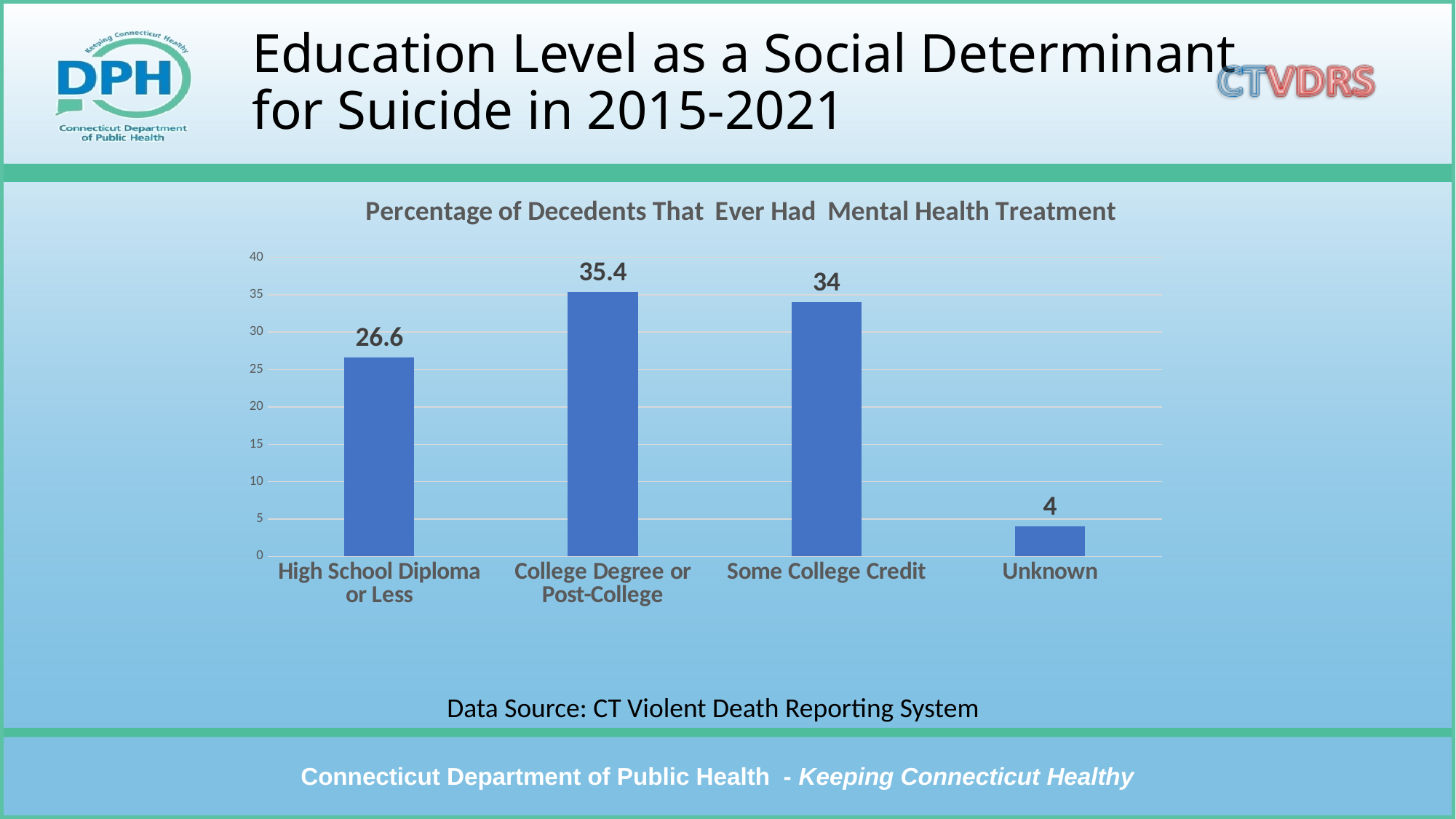
What is the difference between the values for College Degree or Post-College and High School Diploma or Less? 8.8 What is the value for College Degree or Post-College? 35.4 How many categories are shown in the chart? 4 What is the value for High School Diploma or Less? 26.6 What is the value for Unknown? 4 Which category has the highest value? College Degree or Post-College What is the value for Some College Credit? 34 What kind of chart is shown on the slide? Bar chart What is the difference between the values for Some College Credit and Unknown? 30 What is the title of the chart? Percentage of Decedents That Ever Had Mental Health Treatment Which category has the lowest value? Unknown Which is larger, the value for High School Diploma or Less or the value for Some College Credit? Some College Credit